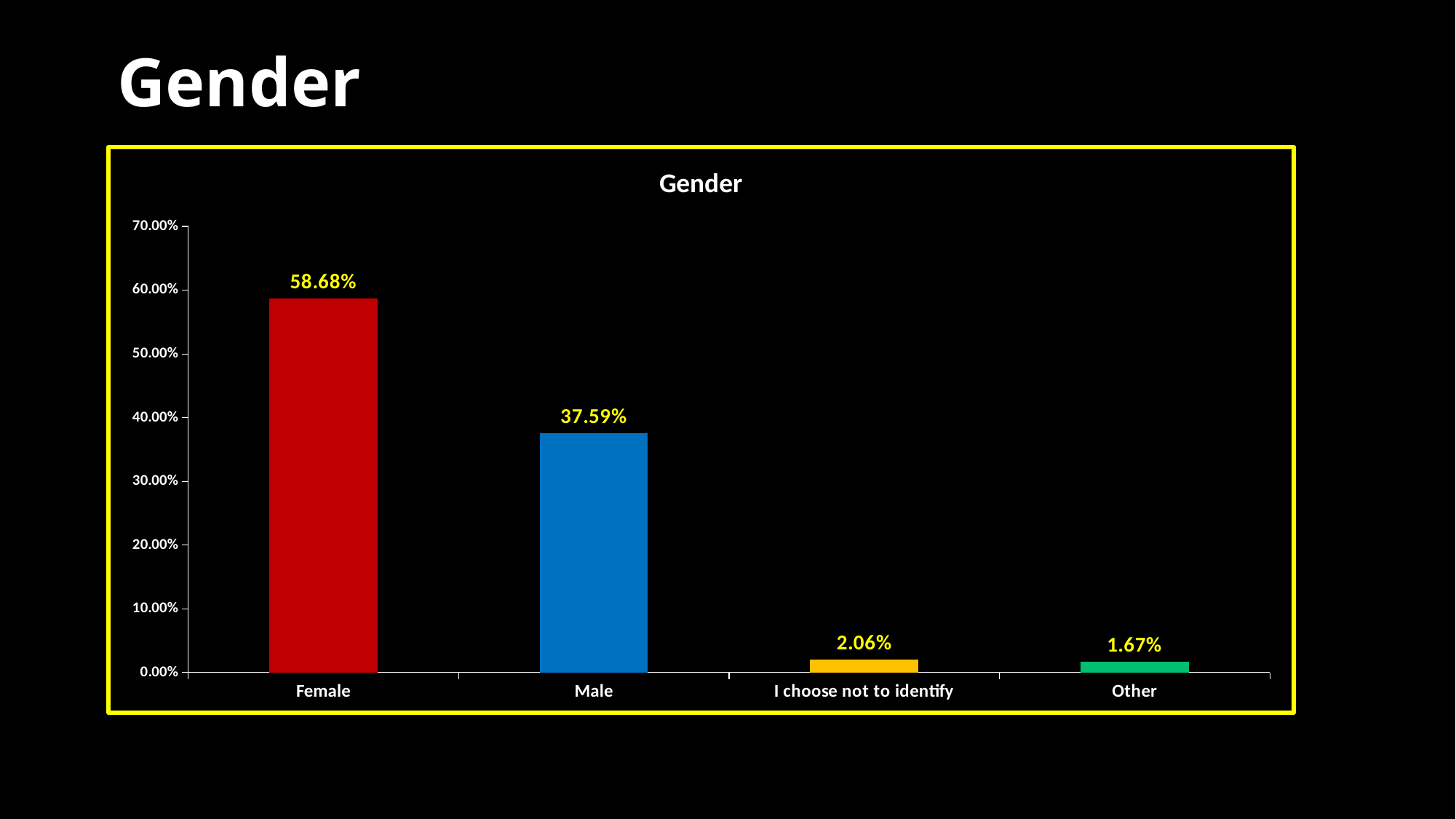
Which is larger, the value for Male or the value for Other? Male What is the value for 'I choose not to identify'? 2.06% What is the difference between the Female and Male values? 21.09% What is the value for Male? 37.59% What is the value for Female? 58.68% Which category has the lowest value? Other Which category has the highest value? Female What is the title of the chart? Gender Is the value for Male greater or less than 40.00%? less What is the value for Other? 1.67% What kind of chart is shown? bar chart How many categories are shown on the x axis? 4